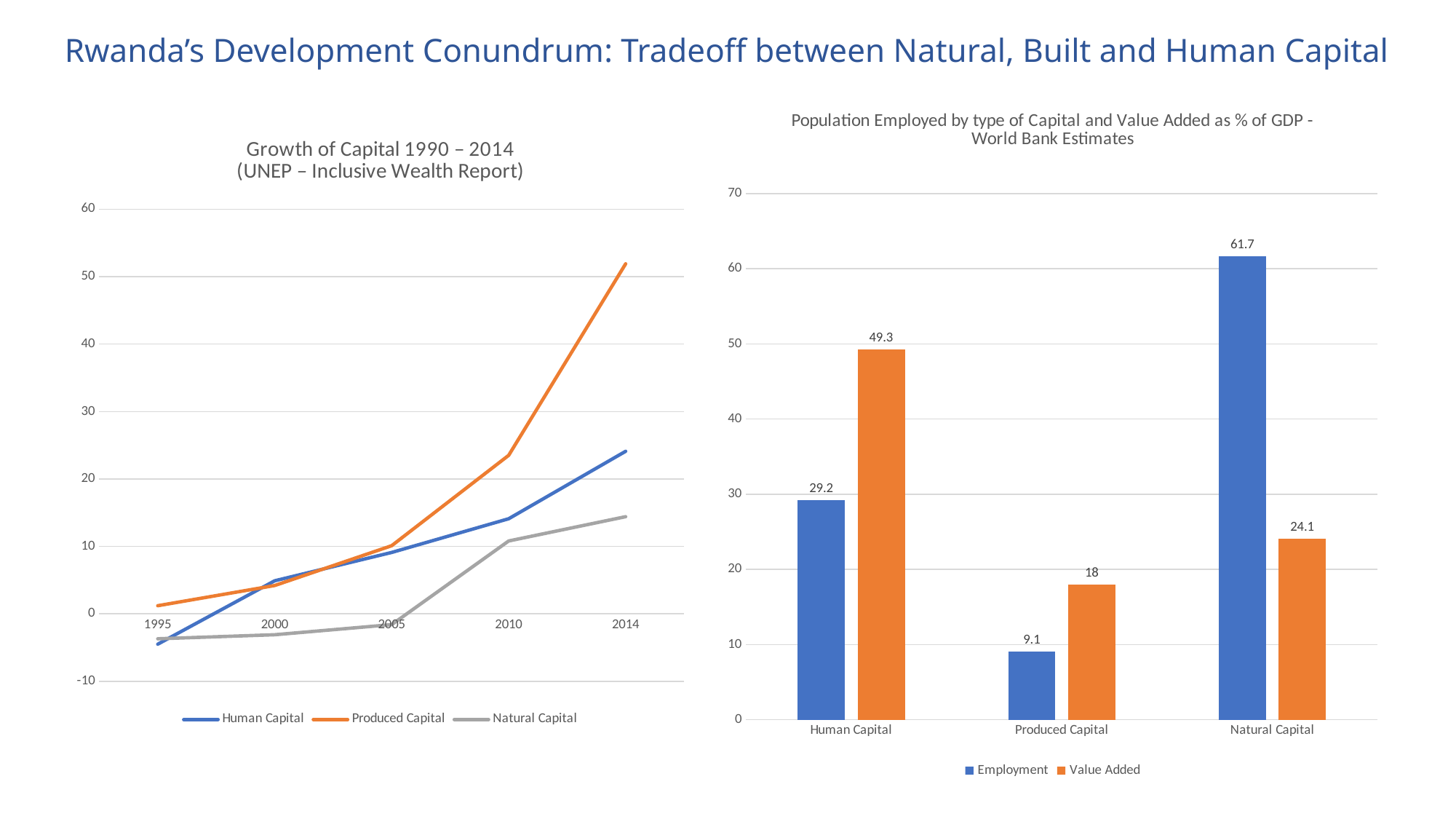
In the 'Population Employed by type of Capital and Value Added as % of GDP' chart, which is larger for Human Capital: Employment or Value Added? Value Added In the 'Growth of Capital 1990 – 2014' chart, does the Produced Capital line rise or fall from 1995 to 2014? Rise In the 'Population Employed by type of Capital and Value Added as % of GDP' chart, which category has the highest Employment value? Natural Capital What kind of chart is the 'Growth of Capital 1990 – 2014' chart on the left? Line chart In the 'Population Employed by type of Capital and Value Added as % of GDP' chart, what is the Employment value for Natural Capital? 61.7 In the 'Population Employed by type of Capital and Value Added as % of GDP' chart, what is the Employment value for Produced Capital? 9.1 In the 'Population Employed by type of Capital and Value Added as % of GDP' chart, what is the Value Added value for Human Capital? 49.3 In the 'Growth of Capital 1990 – 2014' chart, how many series does the legend list? 3 In the 'Population Employed by type of Capital and Value Added as % of GDP' chart, what is the difference between the Employment and Value Added values for Natural Capital? 37.6 In the 'Population Employed by type of Capital and Value Added as % of GDP' chart, how many series does the legend list? 2 In the 'Growth of Capital 1990 – 2014' chart, is the value for Produced Capital in 2014 greater or less than 50? greater In the 'Population Employed by type of Capital and Value Added as % of GDP' chart, which category has the lowest Value Added value? Produced Capital